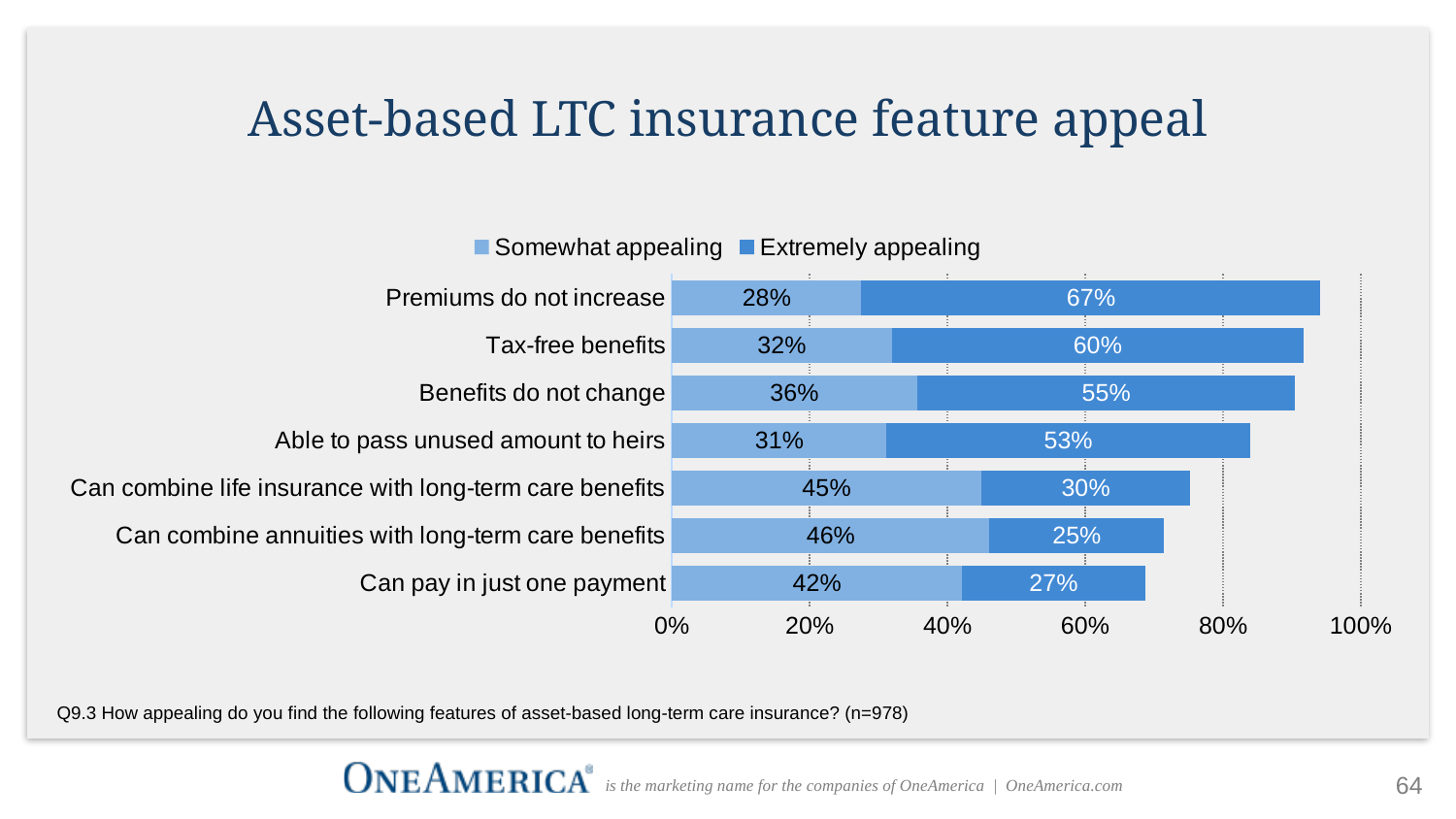
Which feature has the lowest 'Extremely appealing' percentage? Can combine annuities with long-term care benefits What percentage of respondents found 'Can combine annuities with long-term care benefits' somewhat appealing? 46% What is the title of the chart? Asset-based LTC insurance feature appeal What is the combined total of 'Somewhat appealing' and 'Extremely appealing' for 'Premiums do not increase'? 95% What is the combined total of 'Somewhat appealing' and 'Extremely appealing' for 'Can pay in just one payment'? 69% What kind of chart is shown on the slide? Stacked bar chart Which feature has the highest 'Extremely appealing' percentage? Premiums do not increase What percentage of respondents found 'Premiums do not increase' extremely appealing? 67% Which is larger: the 'Somewhat appealing' percentage for 'Can pay in just one payment' or for 'Able to pass unused amount to heirs'? Can pay in just one payment How many features are listed in the chart? 7 What is the difference between the 'Extremely appealing' percentages for 'Tax-free benefits' and 'Benefits do not change'? 5% How many series does the legend list? 2